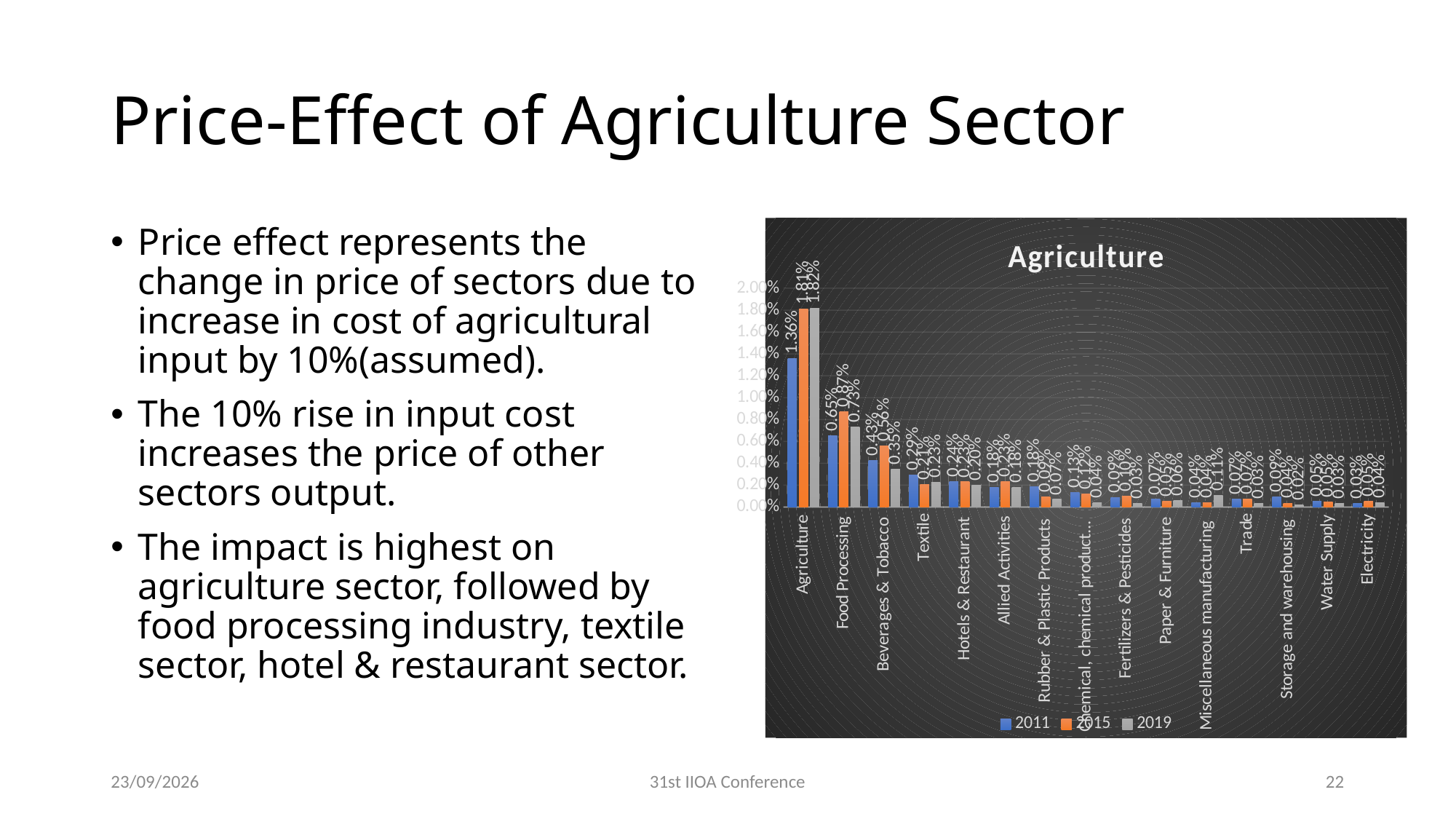
Which sector has the highest 2019 value in the chart? Agriculture What kind of chart is shown on the slide? bar chart What is the difference between the 2015 and 2011 values for Agriculture? 0.45% What is the 2019 value for Agriculture in the chart? 1.82% How many sector categories are plotted along the x axis of the Agriculture chart? 15 How many series does the legend of the Agriculture chart list? 3 What are the legend entries of the chart? 2011, 2015, 2019 What is the 2015 value for Food Processing in the chart? 0.87% Is the 2011 value for Beverages & Tobacco greater or less than 0.60%? less Which year has the lowest value for the Agriculture sector? 2011 For Food Processing, which year has the larger value, 2015 or 2019? 2015 What is the 2011 value for Agriculture in the chart? 1.36%